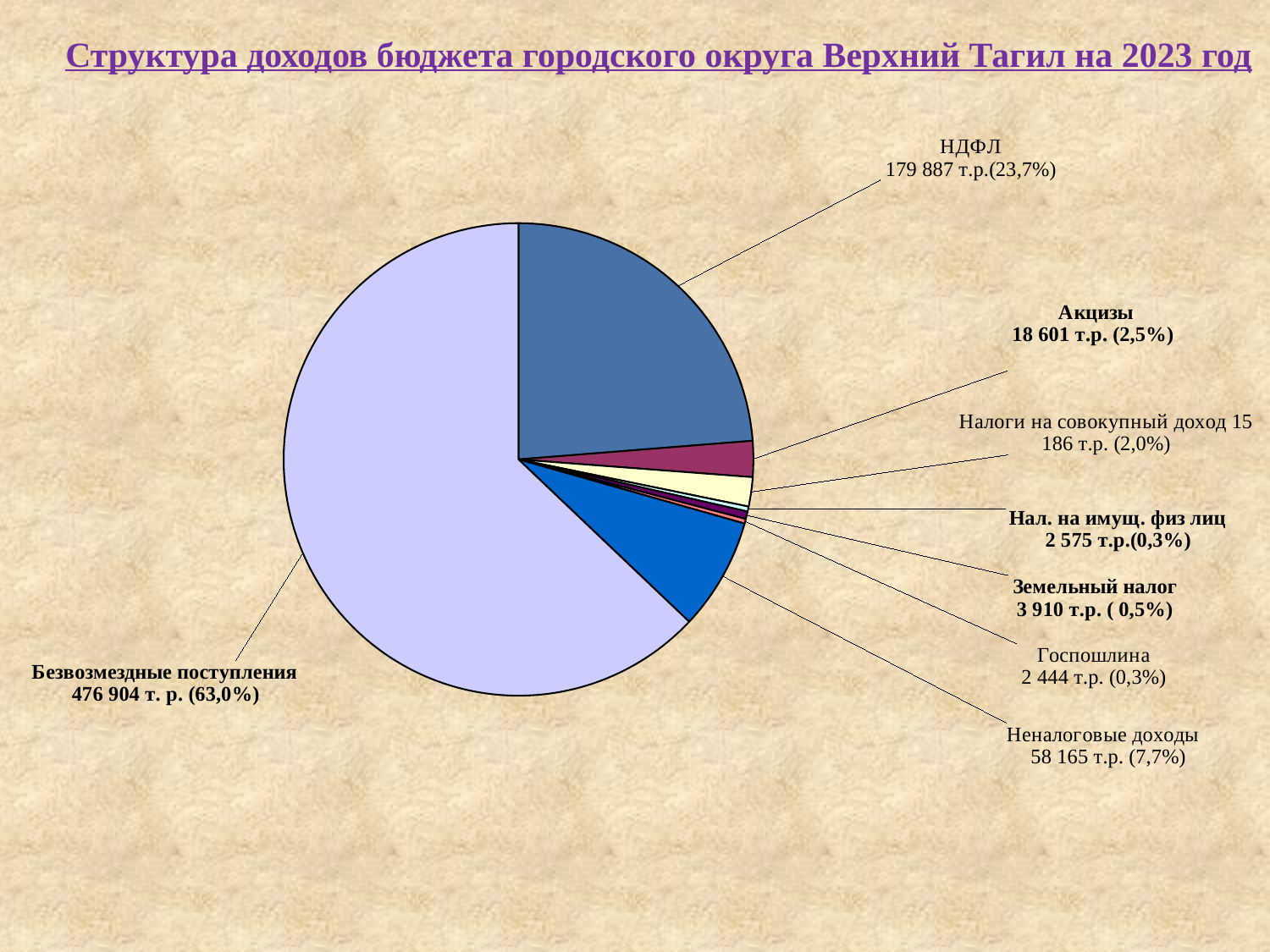
What is the value for НДФЛ? 179 887 т.р. What is the value for Неналоговые доходы? 58 165 т.р. What is the value for Акцизы? 18 601 т.р. What is the title of the chart? Структура доходов бюджета городского округа Верхний Тагил на 2023 год What is the difference between the values for НДФЛ and Неналоговые доходы? 121 722 т.р. Which is larger, the value for Акцизы or the value for Налоги на совокупный доход? Акцизы How many slices does the pie chart have? 8 What share of the pie does Безвозмездные поступления represent? 63,0% What share of the pie does Земельный налог represent? 0,5% Which category has the largest slice of the pie? Безвозмездные поступления What type of chart is shown on the slide? pie chart Which category has the smallest value in the pie chart? Госпошлина